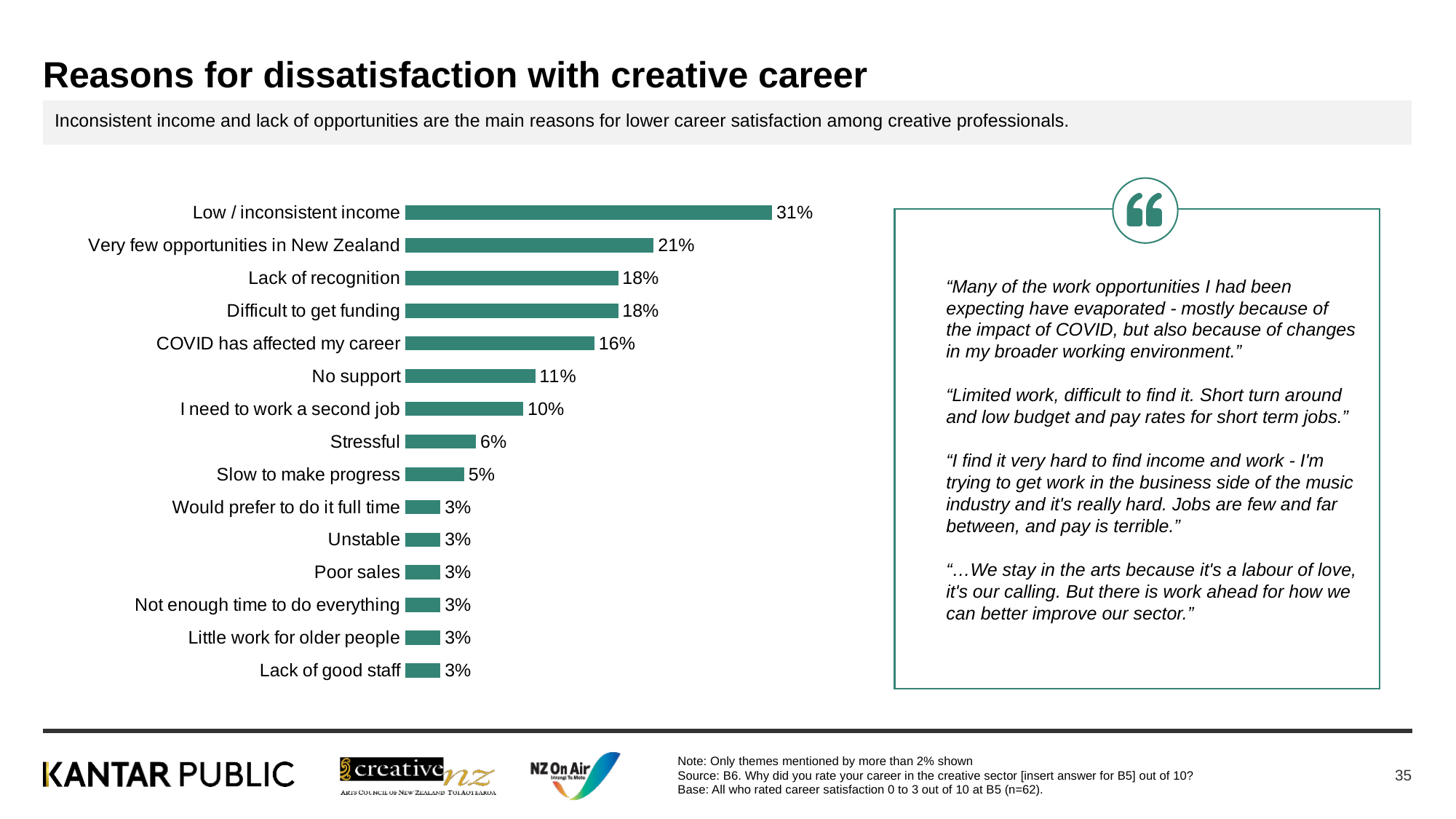
What is the difference between 'Lack of recognition' and 'Stressful'? 12 percentage points Which reason for dissatisfaction has the highest percentage? Low / inconsistent income What percentage is shown for 'I need to work a second job'? 10% How many reasons for dissatisfaction are listed in the chart? 15 What percentage of respondents cited 'Low / inconsistent income' as a reason for dissatisfaction? 31% What value is shown for 'Slow to make progress'? 5% What type of chart is used on this slide? Bar chart Which has a higher value: 'No support' or 'Stressful'? No support What is the value shown for 'COVID has affected my career'? 16% How many reasons in the chart are shown with a value of 3%? 6 What is the difference in percentage points between 'Low / inconsistent income' and 'Very few opportunities in New Zealand'? 10 percentage points What is the title of the chart on this slide? Reasons for dissatisfaction with creative career